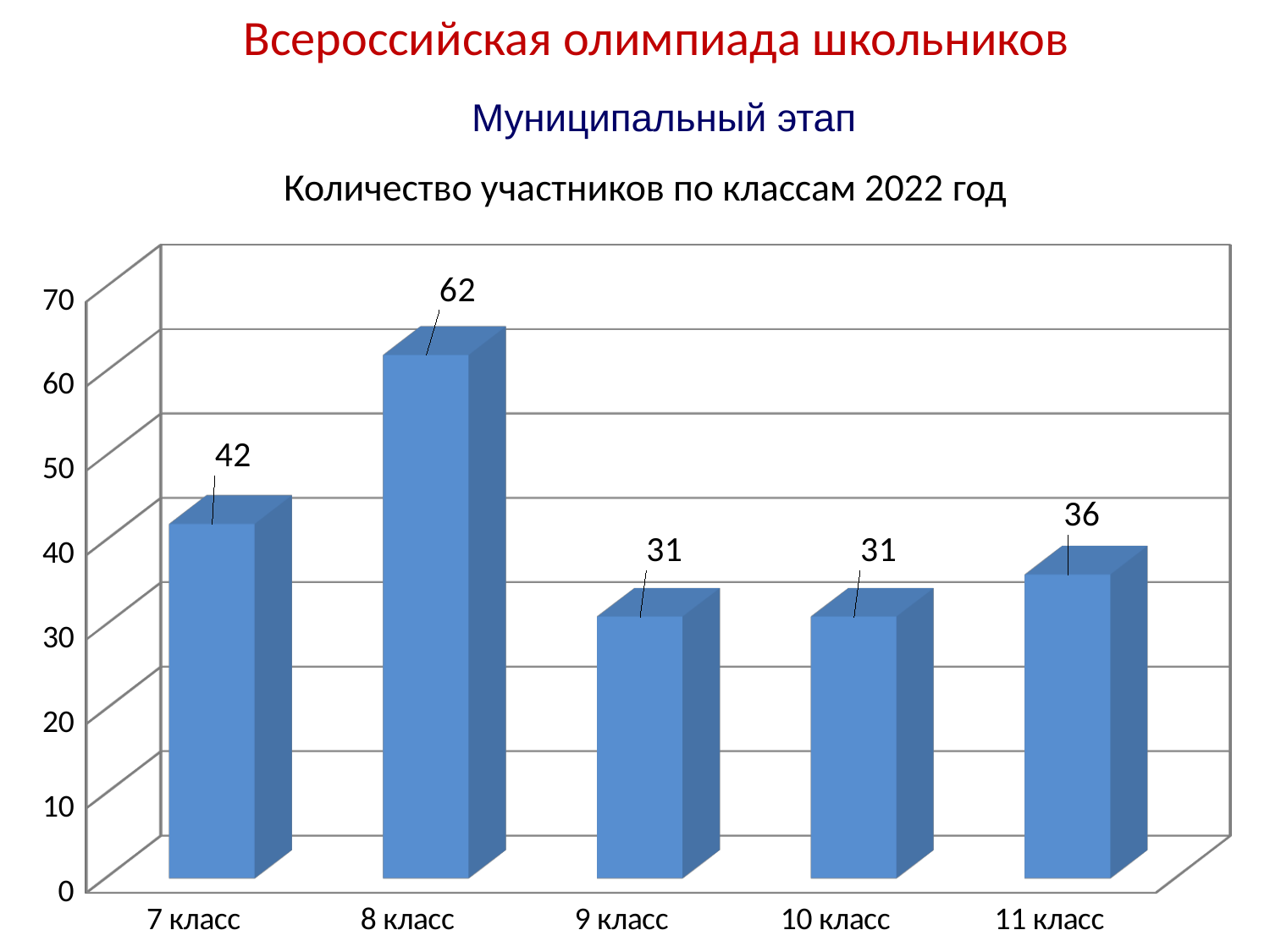
What is the title of the chart? Количество участников по классам 2022 год What is the value for 8 класс? 62 How many classes are shown on the chart? 5 Which two classes have the same value? 9 класс and 10 класс What is the difference between the values for 8 класс and 7 класс? 20 What is the difference between the values for 11 класс and 9 класс? 5 Which class has the highest number of participants? 8 класс What is the value for 11 класс? 36 Which is larger, the value for 7 класс or the value for 11 класс? 7 класс What is the value for 7 класс? 42 What kind of chart is shown on the slide? bar chart Is the value for 8 класс greater or less than 50? greater